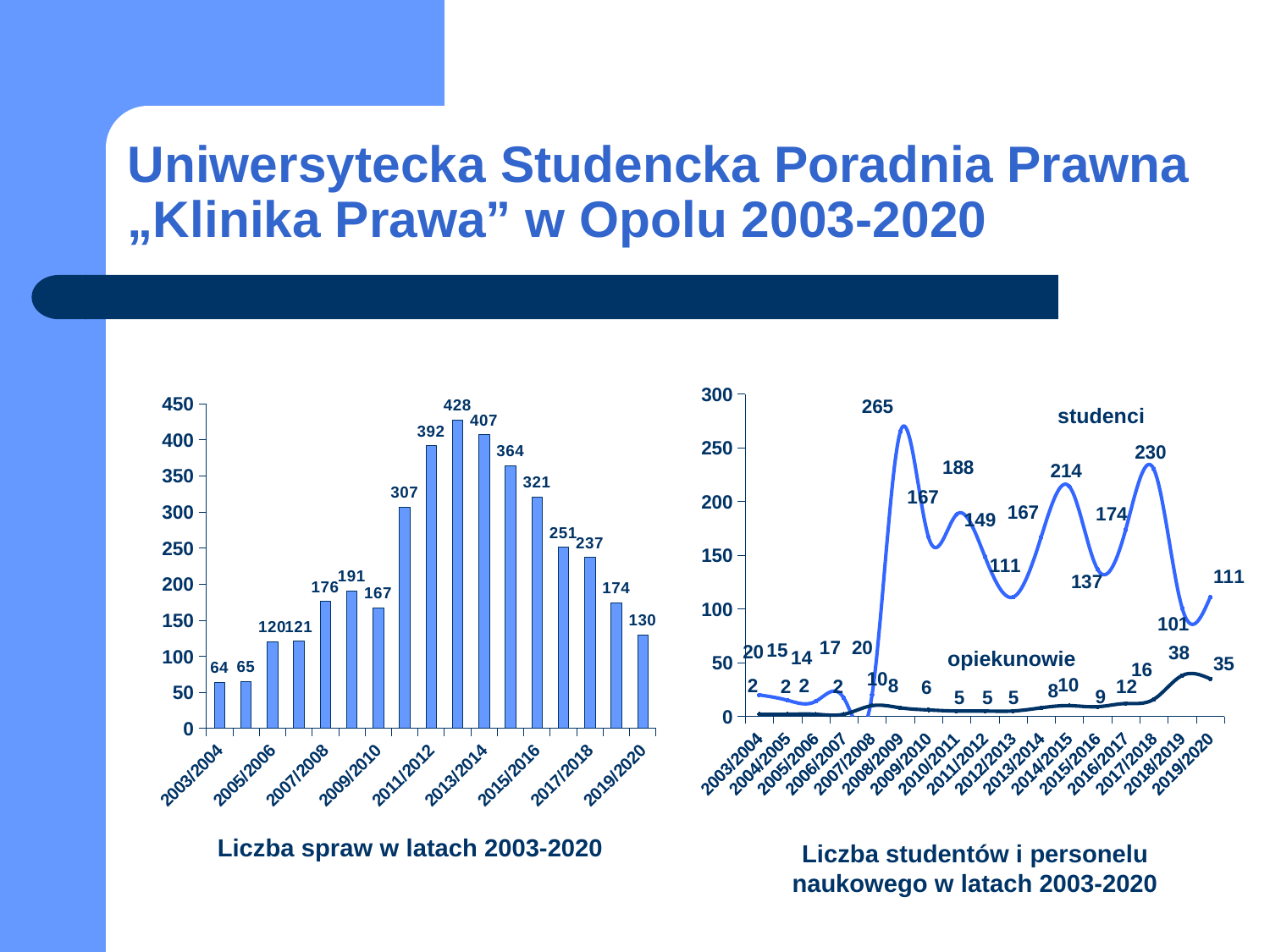
What kind of chart is the right chart, "Liczba studentów i personelu naukowego w latach 2003-2020"? line chart How many series are plotted in the right chart "Liczba studentów i personelu naukowego w latach 2003-2020"? 2 In the left chart "Liczba spraw w latach 2003-2020", what is the value for 2019/2020? 130 In the left chart "Liczba spraw w latach 2003-2020", what is the lowest value shown? 64 In the left chart "Liczba spraw w latach 2003-2020", what is the difference between the value for 2019/2020 and the value for 2003/2004? 66 In the left chart "Liczba spraw w latach 2003-2020", what is the value for 2003/2004? 64 How many bars are plotted in the left chart "Liczba spraw w latach 2003-2020"? 17 In the right chart "Liczba studentów i personelu naukowego w latach 2003-2020", what is the highest value of the opiekunowie series? 38 In the left chart "Liczba spraw w latach 2003-2020", what is the highest value shown? 428 In the left chart "Liczba spraw w latach 2003-2020", which is larger: the value for 2003/2004 or the value for 2019/2020? 2019/2020 In the right chart "Liczba studentów i personelu naukowego w latach 2003-2020", what is the highest value of the studenci series? 265 What kind of chart is the left chart, "Liczba spraw w latach 2003-2020"? bar chart